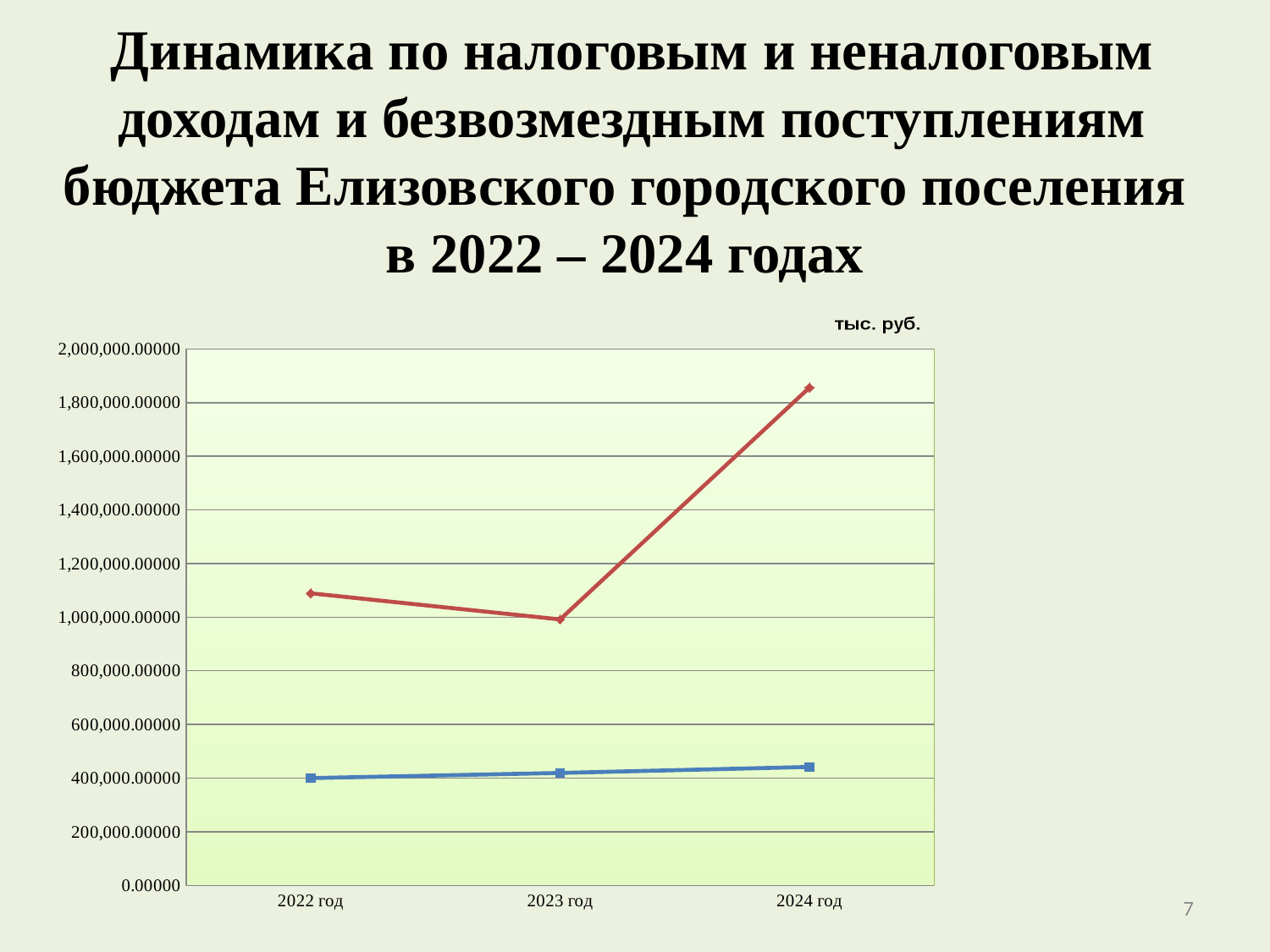
Is the value of the red line for 2024 год greater or less than 1,600,000.00000? greater Is the value of the blue line for 2024 год greater or less than 600,000.00000? less What kind of chart is shown on the slide? Line chart Is the value of the red line for 2023 год greater or less than 1,200,000.00000? less Does the blue line rise or fall from 2022 год to 2024 год? Rise How many years are shown on the x axis of the chart? 3 In which year does the red line reach its lowest value? 2023 год How many lines are plotted on the chart? 2 Which line has the larger value in 2023 год, the red line or the blue line? The red line What unit of measurement is written above the chart? тыс. руб. In which year does the red line reach its highest value? 2024 год